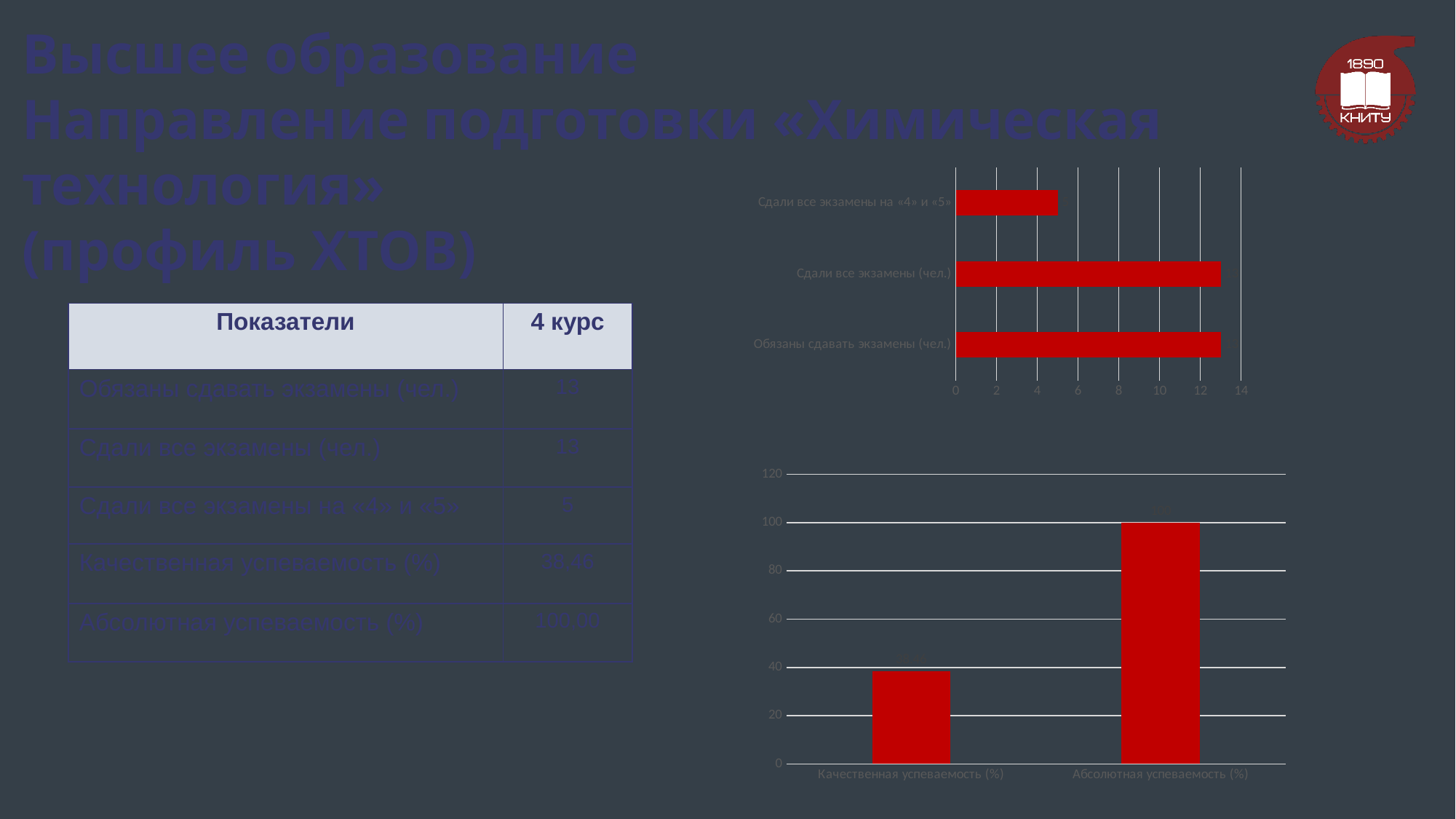
In the bottom-right chart, which category has the highest value? Абсолютная успеваемость (%) How many categories does the top-right bar chart show? 3 In the top-right chart, is the value for «Сдали все экзамены на «4» и «5»» greater or less than 8? less What kind of chart is the top-right chart on the slide? bar chart In the top-right chart, which is larger: «Сдали все экзамены (чел.)» or «Сдали все экзамены на «4» и «5»»? Сдали все экзамены (чел.) How many categories does the bottom-right bar chart show? 2 In the top-right chart, is the value for «Обязаны сдавать экзамены (чел.)» greater or less than 10? greater In the bottom-right chart, is the value for «Качественная успеваемость (%)» greater or less than 60? less What is the highest tick value on the vertical axis of the bottom-right chart? 120 In the top-right chart, which category has the lowest value? Сдали все экзамены на «4» и «5» What kind of chart is the bottom-right chart on the slide? bar chart In the bottom-right chart, what is the value for «Абсолютная успеваемость (%)»? 100